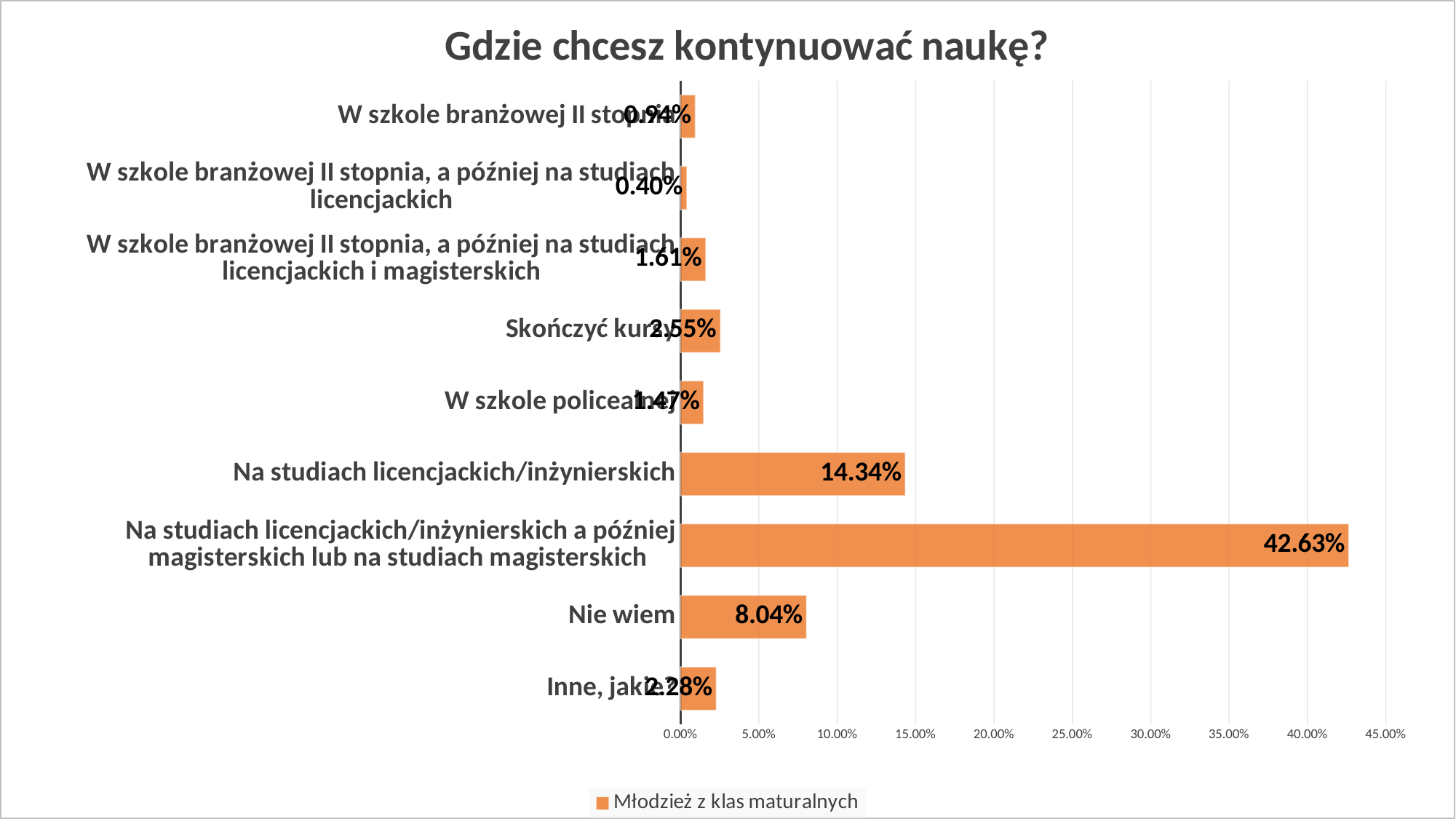
What is the title of the chart? Gdzie chcesz kontynuować naukę? What is the value for "Na studiach licencjackich/inżynierskich"? 14.34% How many categories are plotted in the chart? 9 Which category has the lowest value? W szkole branżowej II stopnia, a później na studiach licencjackich How many series does the legend list? 1 Which category has the highest value? Na studiach licencjackich/inżynierskich a później magisterskich lub na studiach magisterskich What is the value for "Nie wiem"? 8.04% What is the value for "W szkole branżowej II stopnia, a później na studiach licencjackich i magisterskich"? 1.61% What is the difference between the values for "Na studiach licencjackich/inżynierskich" and "Nie wiem"? 6.30% What is the value for "Na studiach licencjackich/inżynierskich a później magisterskich lub na studiach magisterskich"? 42.63% What type of chart is shown on the slide? bar chart Which is larger: the value for "Nie wiem" or the value for "Na studiach licencjackich/inżynierskich"? Na studiach licencjackich/inżynierskich